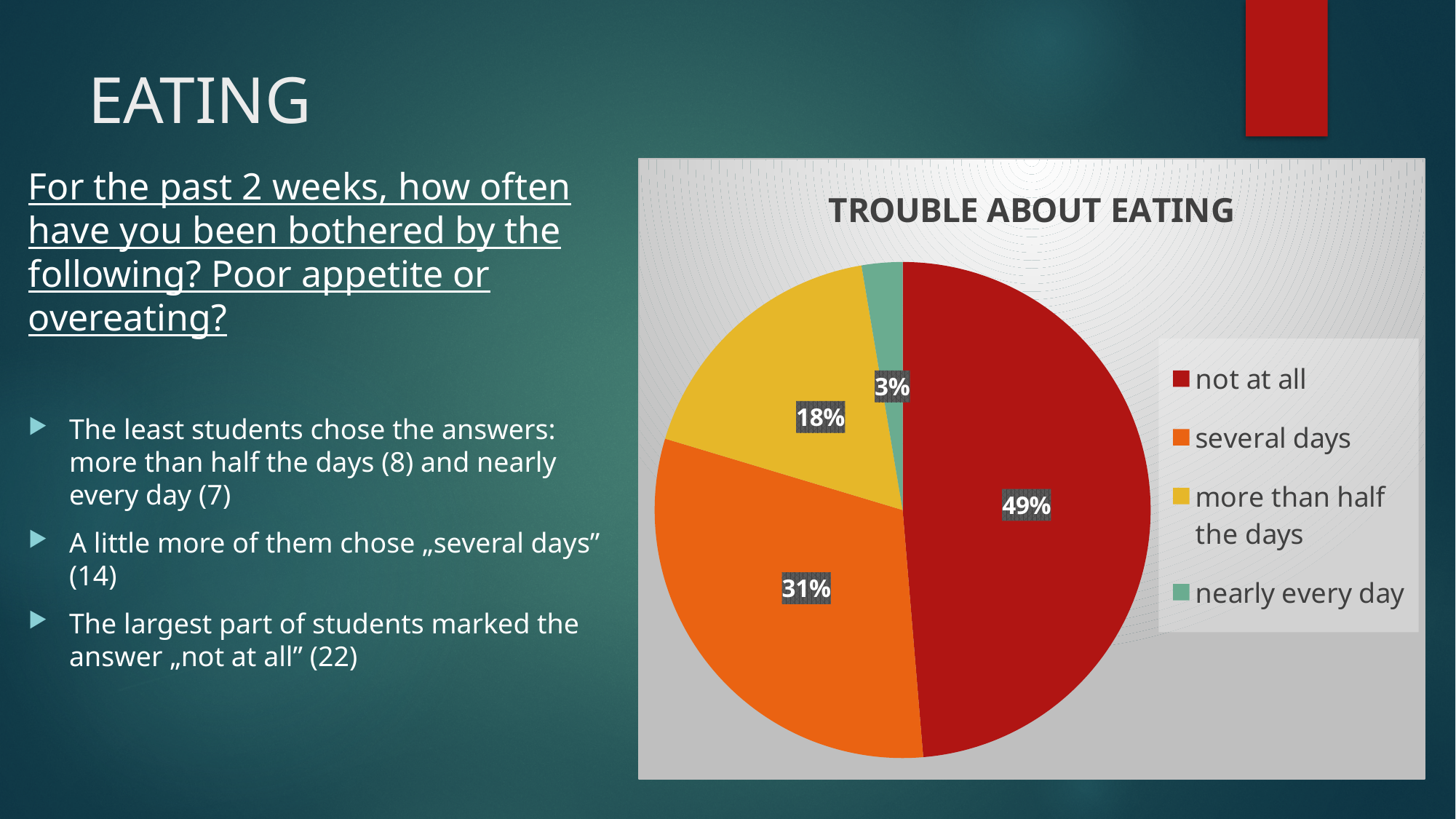
What colour is the slice for "more than half the days"? yellow Which slice is larger, "several days" or "more than half the days"? several days How many categories does the legend list? 4 What percentage of the pie is labelled for "several days"? 31% Which category has the smallest slice of the pie? nearly every day What kind of chart is shown on the slide? pie chart What percentage of the pie is labelled for "not at all"? 49% What percentage of the pie is labelled for "more than half the days"? 18% What percentage of the pie is labelled for "nearly every day"? 3% What is the title of the chart? TROUBLE ABOUT EATING Which category has the largest slice of the pie? not at all What is the difference in percentage points between the "not at all" slice and the "several days" slice? 18